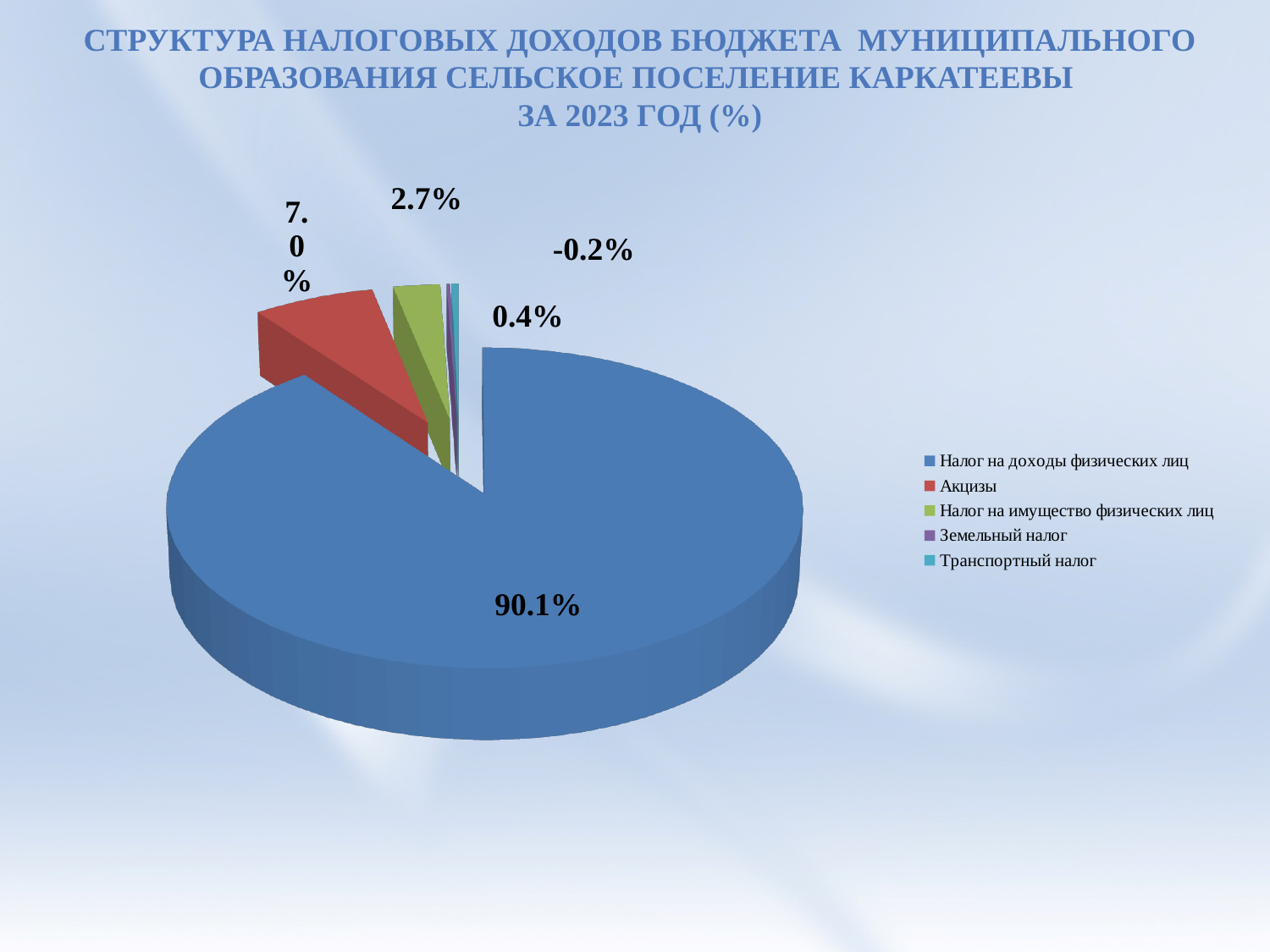
What share of tax revenues does Налог на доходы физических лиц account for? 90.1% What is the value shown for Налог на имущество физических лиц? 2.7% What kind of chart is shown on the slide? pie chart What is the difference between the values for Налог на доходы физических лиц and Акцизы? 83.1% What is the smallest value labelled on the pie chart? -0.2% What colour is the slice for Акцизы? red Which category has the largest slice of the pie? Налог на доходы физических лиц Which year does the chart title refer to? 2023 What is the value shown for Акцизы? 7.0% Which is larger, the value for Акцизы or the value for Налог на имущество физических лиц? Акцизы How many categories does the legend list? 5 What is the difference between the values for Акцизы and Налог на имущество физических лиц? 4.3%